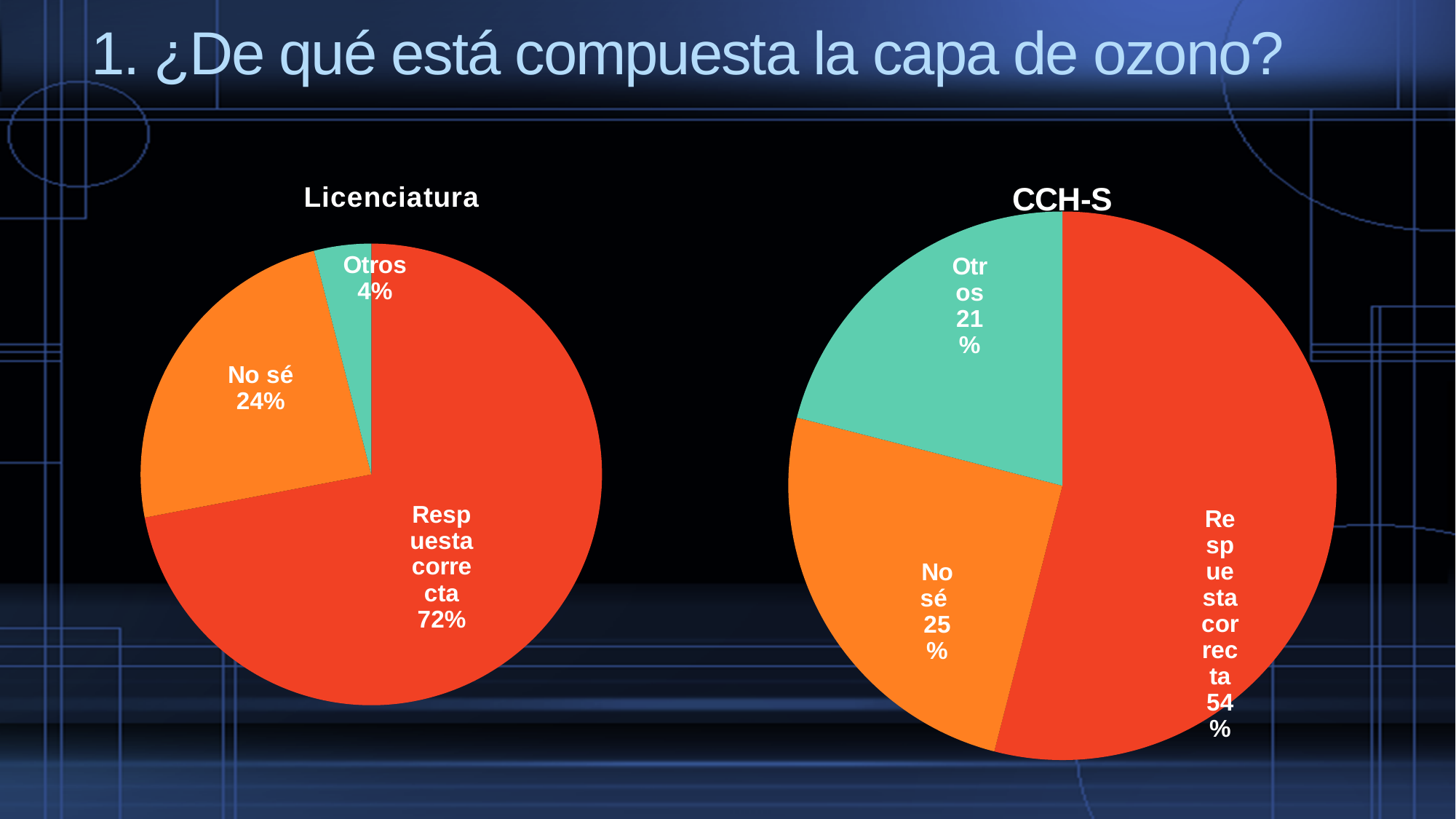
How many categories does the CCH-S chart show? 3 What kind of chart is the Licenciatura chart? Pie chart Which chart has the larger Otros share, Licenciatura or CCH-S? CCH-S In the CCH-S chart, what share does No sé have? 25% In the CCH-S chart, which category has the smallest slice? Otros In the CCH-S chart, what share does Respuesta correcta have? 54% In the Licenciatura chart, what is the difference between the Respuesta correcta and No sé shares? 48% In the Licenciatura chart, what share does No sé have? 24% In the Licenciatura chart, which category has the largest slice? Respuesta correcta